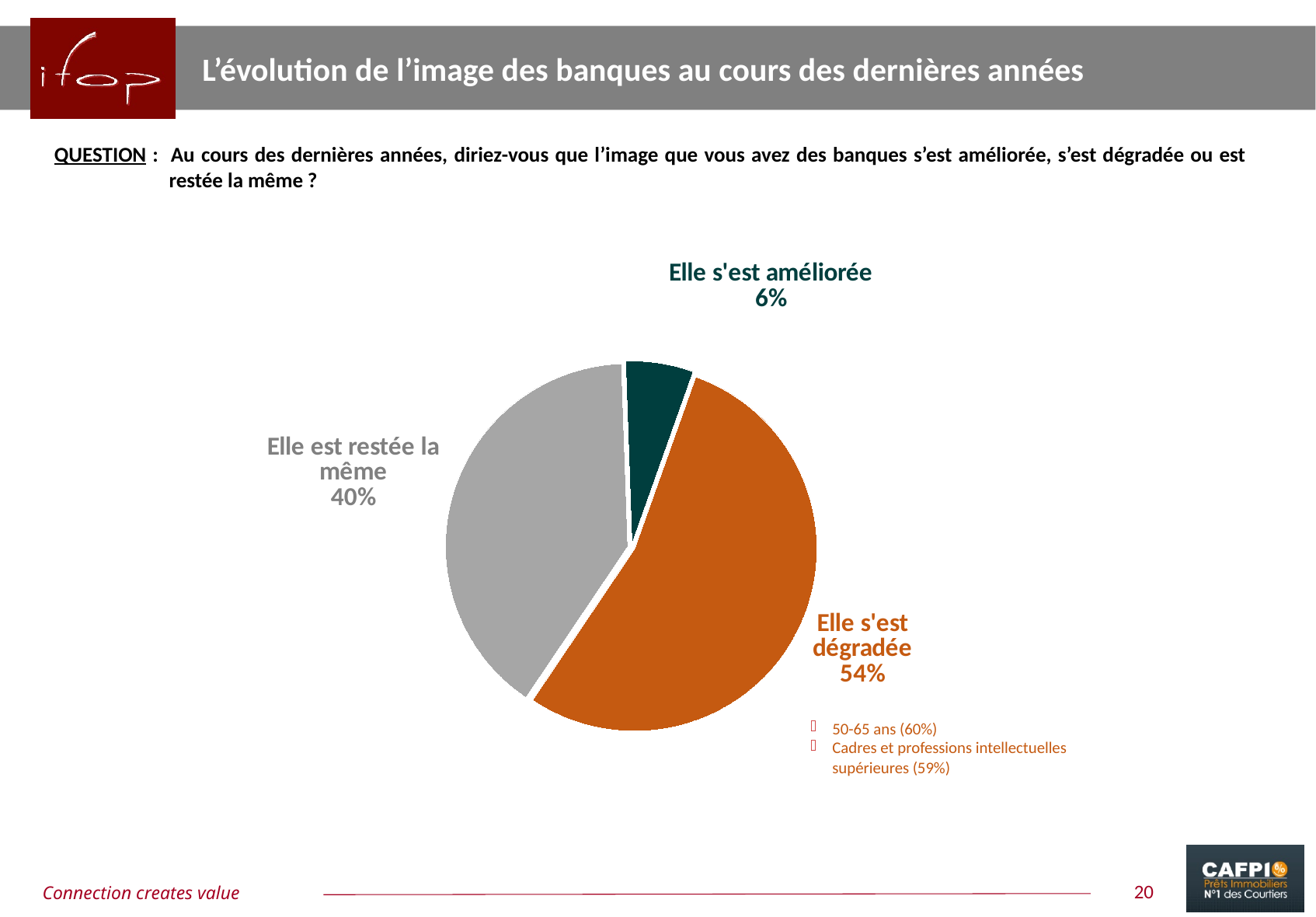
According to the note under the chart, what percentage of 50-65 year olds said the image has deteriorated? 60% What is the difference in percentage points between "Elle est restée la même" and "Elle s'est améliorée"? 34 Which response has the smallest share of the pie? Elle s'est améliorée What colour is the slice for "Elle s'est dégradée"? orange How many slices does the pie chart have? 3 What kind of chart is shown on the slide? pie chart What percentage of respondents said the image of banks has improved ("Elle s'est améliorée")? 6% What percentage of respondents said the image of banks stayed the same ("Elle est restée la même")? 40% Which is larger: the share for "Elle est restée la même" or the share for "Elle s'est améliorée"? Elle est restée la même What percentage of respondents said the image of banks has deteriorated ("Elle s'est dégradée")? 54% What is the difference in percentage points between "Elle s'est dégradée" and "Elle est restée la même"? 14 Which response has the largest share of the pie? Elle s'est dégradée